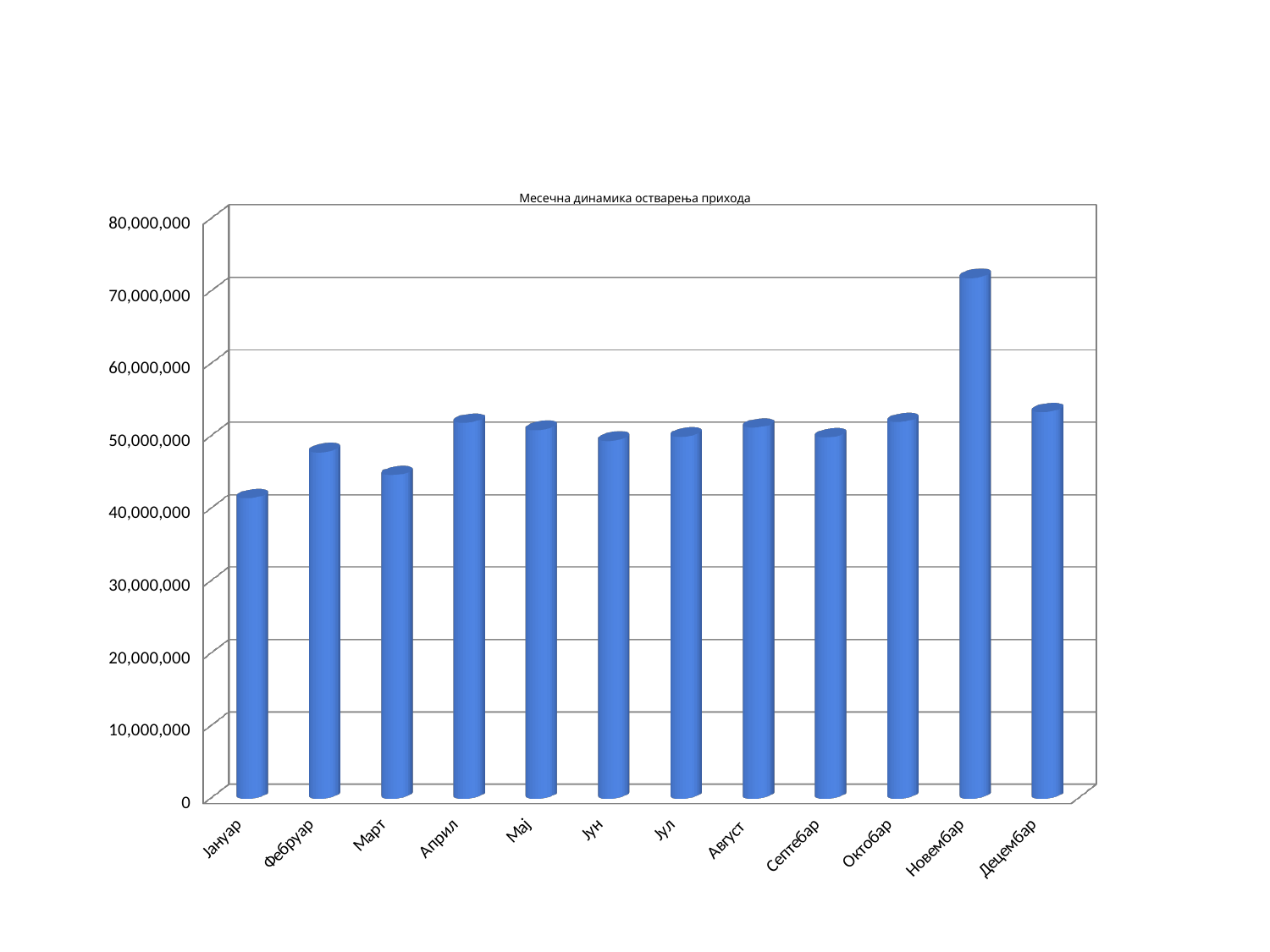
How many months are shown on the x axis of the chart? 12 Which month has the lowest value in the chart? Јануар Which is larger, the value for Март or the value for Април? Април Which is larger, the value for Новембар or the value for Децембар? Новембар Is the value for Децембар greater or less than 50,000,000? greater Is the value for Март greater or less than 40,000,000? greater What is the title of the chart? Месечна динамика остварења прихода Which month has the highest value in the chart? Новембар Is the value for Јануар greater or less than 50,000,000? less Which is larger, the value for Јануар or the value for Фебруар? Фебруар What kind of chart is shown on the slide? bar chart